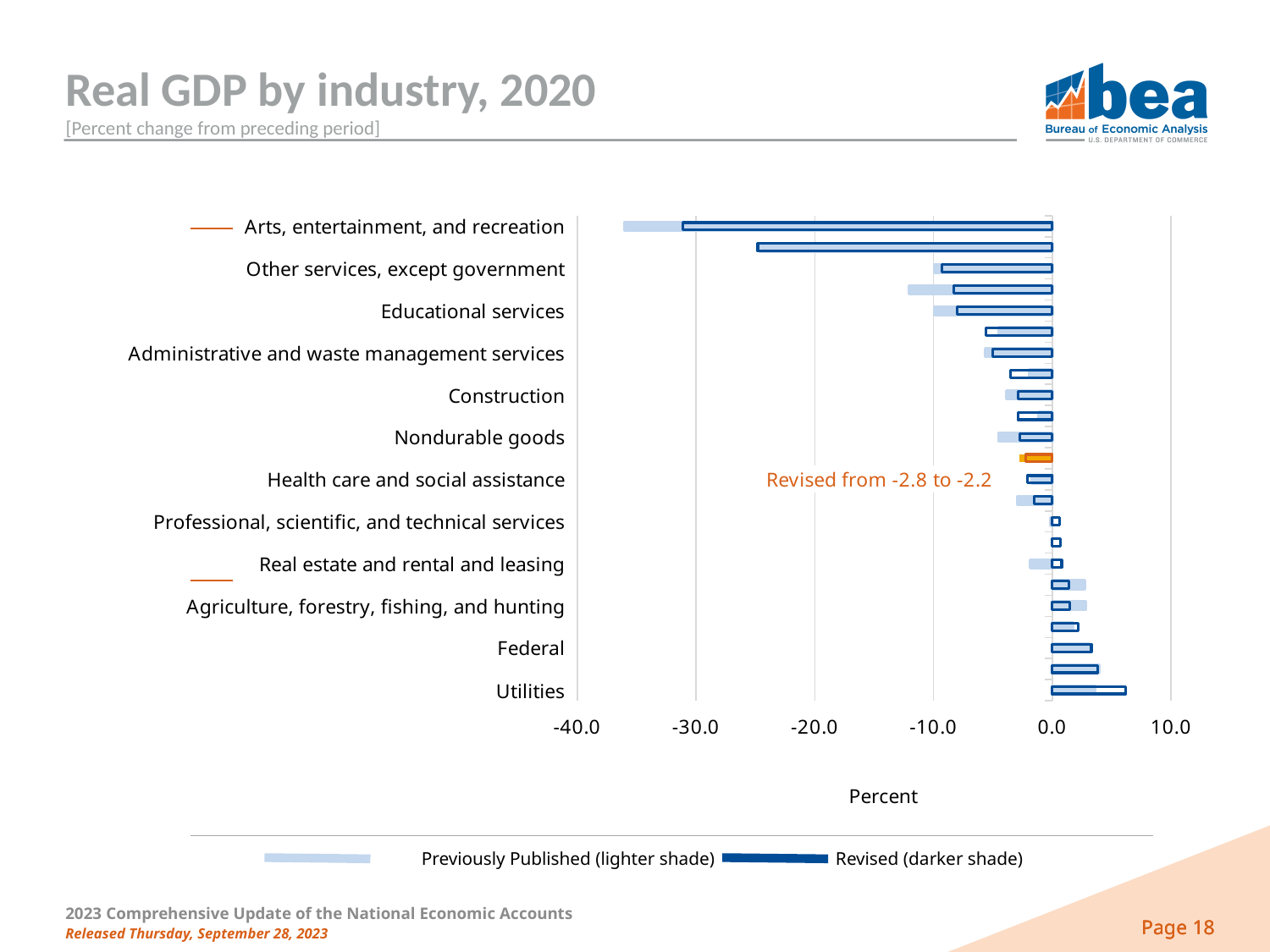
What is the label on the horizontal axis? Percent Is the revised value for Arts, entertainment, and recreation greater or less than -20.0? less Which industry has the lowest (most negative) percent change? Arts, entertainment, and recreation Which series does the lighter shade represent according to the legend? Previously Published Which has the larger percent change, Arts, entertainment, and recreation or Other services, except government? Other services, except government Is the revised value for Federal greater or less than 0.0? greater Which industry has the highest percent change? Utilities What kind of chart is shown on the slide? Bar chart How many series does the legend list? 2 Is the revised value for Construction greater or less than 0.0? less What is the title of the chart? Real GDP by industry, 2020